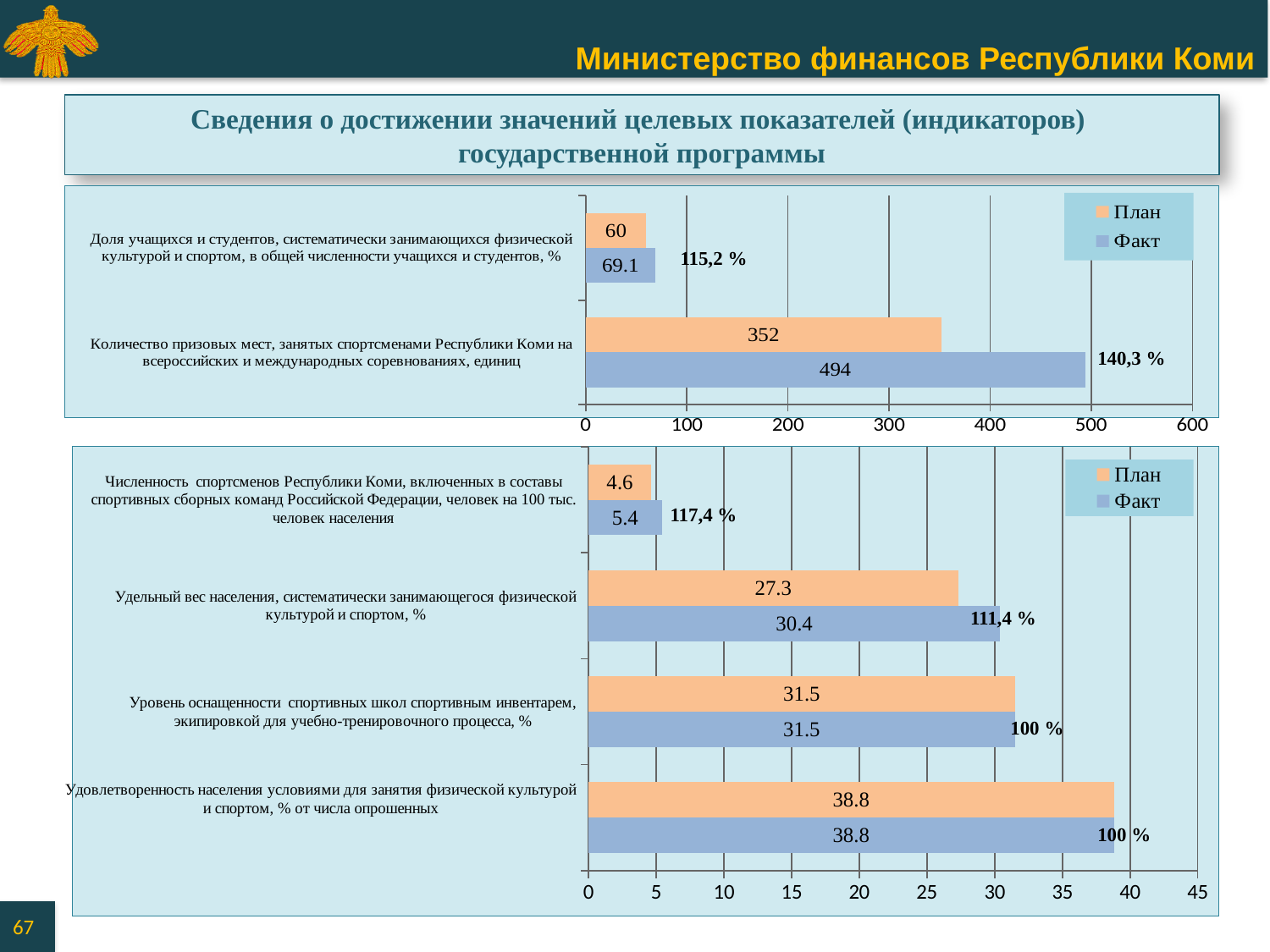
In the bottom chart, which category has the lowest План value? Численность спортсменов Республики Коми, включенных в составы спортивных сборных команд Российской Федерации, человек на 100 тыс. человек населения In the bottom chart, how many categories are shown? 4 In the bottom chart, which is larger for 'Удельный вес населения': the План value or the Факт value? Факт In the top chart, how many series does the legend list? 2 What kind of chart is the top chart? bar chart In the bottom chart, what colour are the Факт bars? blue In the bottom chart, which category has the highest Факт value? Удовлетворенность населения условиями для занятия физической культурой и спортом, % от числа опрошенных In the bottom chart, what is the Факт value for 'Удельный вес населения, систематически занимающегося физической культурой и спортом, %'? 30.4 In the top chart, what is the План value for 'Доля учащихся и студентов, систематически занимающихся физической культурой и спортом'? 60 In the top chart, what is the difference between the Факт and План values for 'Количество призовых мест'? 142 In the top chart, what is the Факт value for 'Количество призовых мест, занятых спортсменами Республики Коми на всероссийских и международных соревнованиях, единиц'? 494 In the bottom chart, what is the План value for 'Численность спортсменов Республики Коми, включенных в составы спортивных сборных команд Российской Федерации'? 4.6